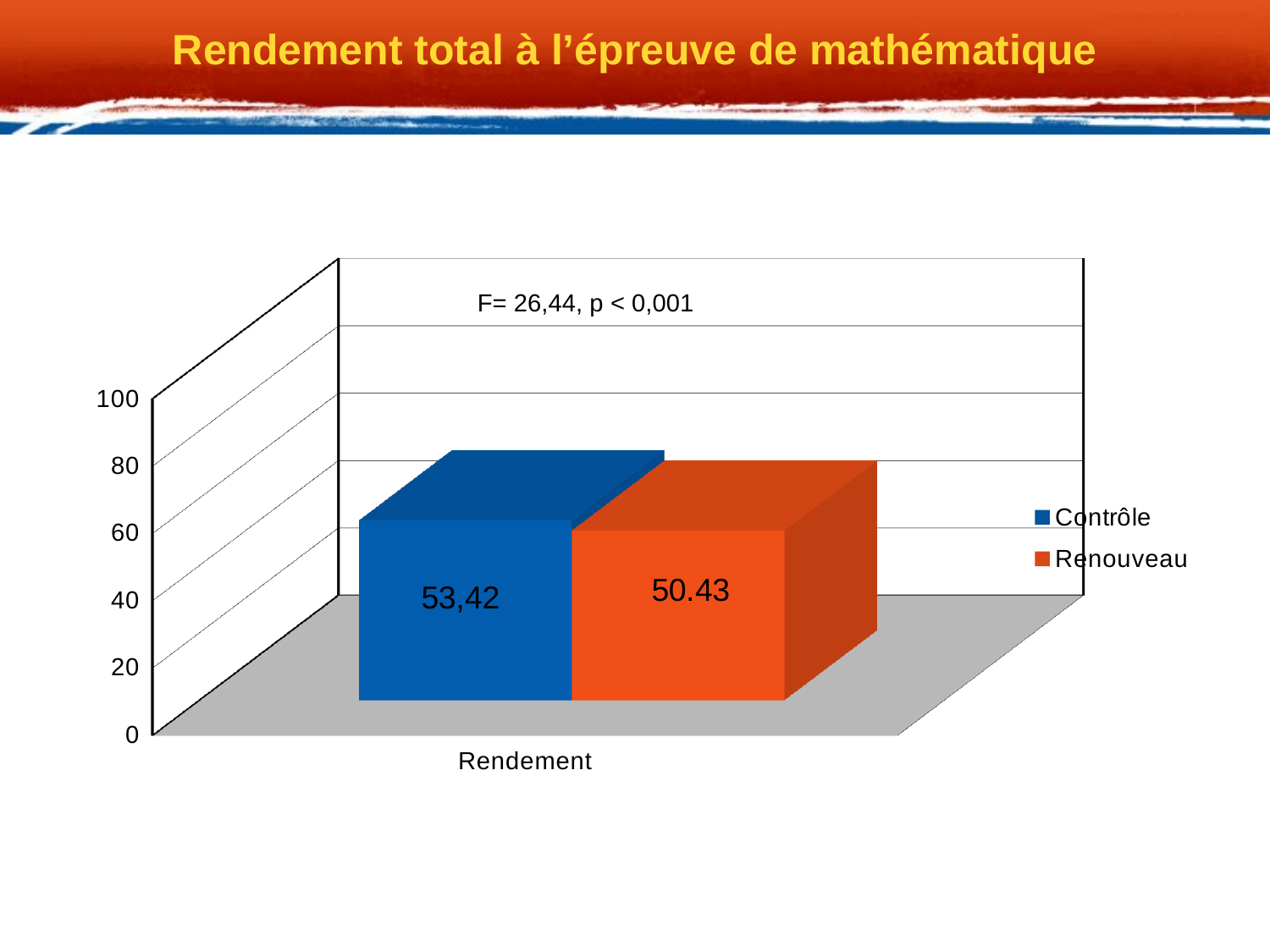
What is the value for Contrôle in the chart? 53,42 What kind of chart is shown on the slide? bar chart What is the value for Renouveau in the chart? 50.43 Is the value for Renouveau greater or less than 40? greater What statistical annotation is printed inside the chart area? F= 26,44, p < 0,001 How many series does the legend list? 2 What is the difference between the Contrôle value and the Renouveau value? 2,99 Which series has the highest value in the chart? Contrôle What is the category label shown on the x axis of the chart? Rendement Which series has the higher value, Contrôle or Renouveau? Contrôle Which series has the lowest value in the chart? Renouveau Is the value for Contrôle greater or less than 60? less